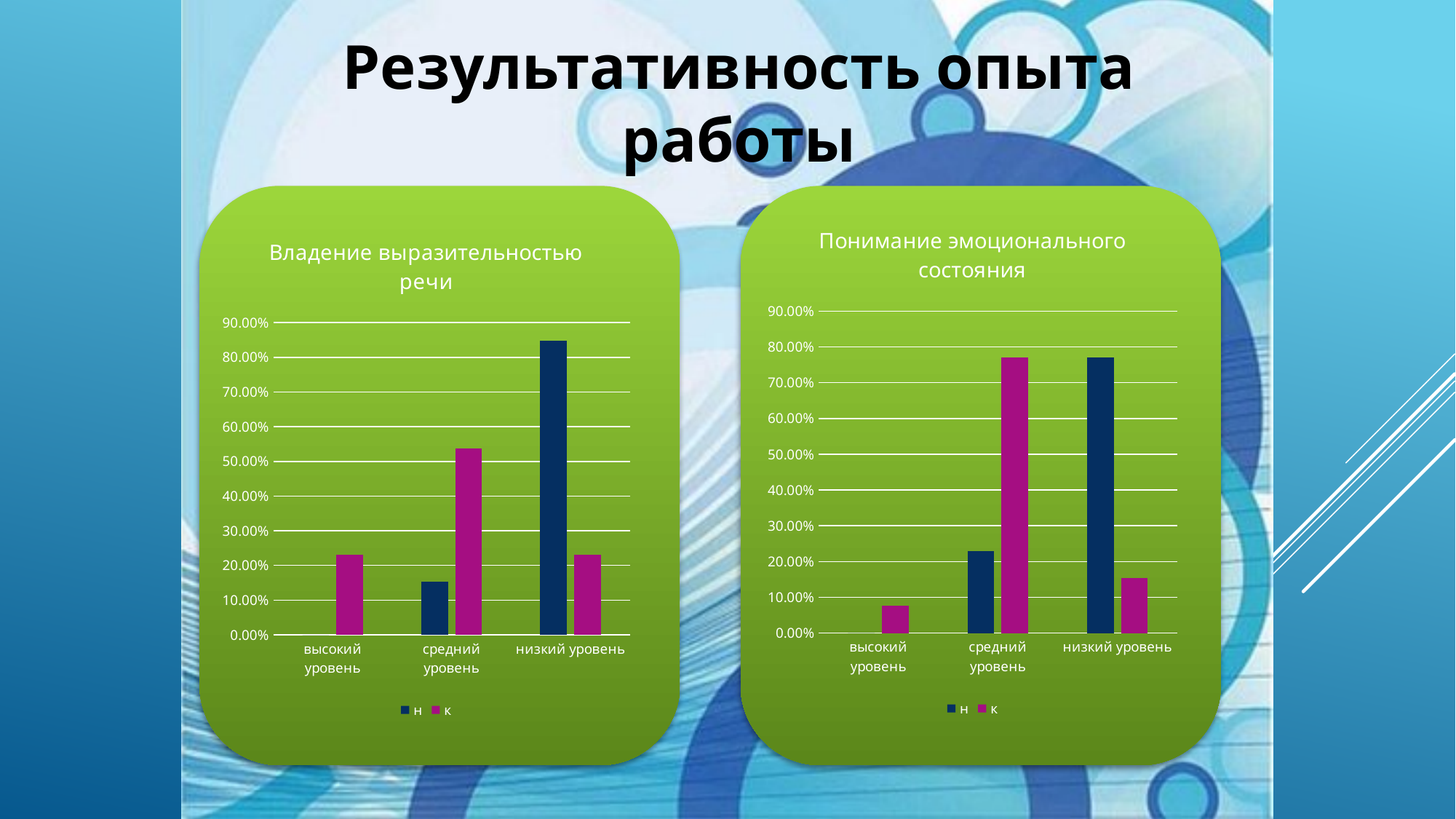
How many series does the legend of "Понимание эмоционального состояния" list? 2 In "Понимание эмоционального состояния", is the value of series н for низкий уровень greater or less than 70.00%? greater In "Владение выразительностью речи", which category has the highest value for series к? средний уровень What kind of chart is "Владение выразительностью речи"? bar chart What colour are the bars of series к in both charts? magenta In "Владение выразительностью речи", is the value of series н for низкий уровень greater or less than 80.00%? greater In "Понимание эмоционального состояния", which category has the lowest value for series к? высокий уровень In "Владение выразительностью речи", is the value of series к for средний уровень greater or less than 50.00%? greater In "Владение выразительностью речи", which category has the highest value for series н? низкий уровень How many categories are shown on the x axis of "Владение выразительностью речи"? 3 In "Понимание эмоционального состояния", for средний уровень, which series has the larger value, н or к? к